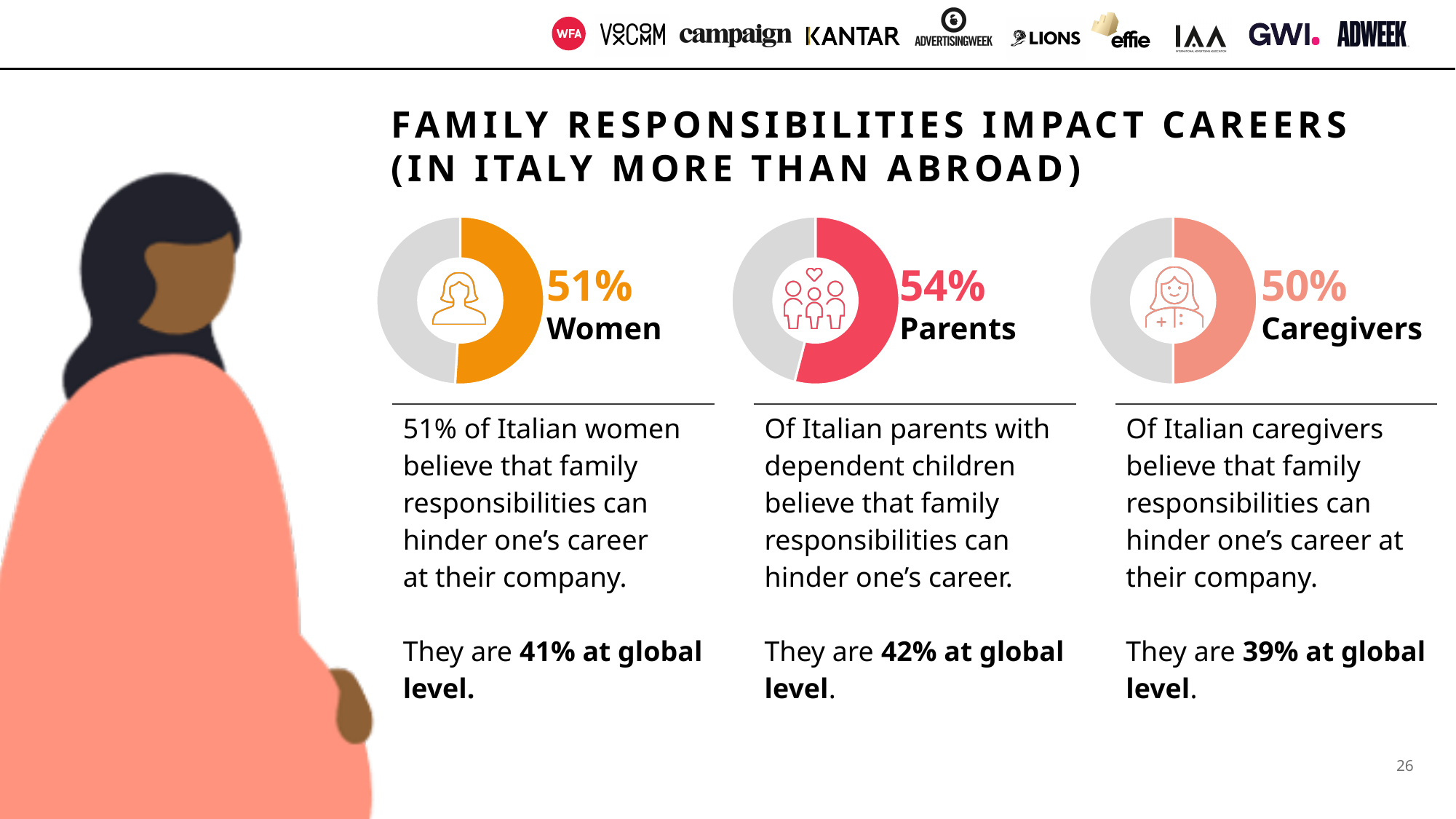
According to the text under the Caregivers chart, what is the caregivers figure at global level? 39% Which of the three donut charts shows the lowest percentage? Caregivers What colour is the filled portion of the Women donut chart? Orange Which is larger, the Women percentage or the Caregivers percentage? Women Which of the three donut charts shows the highest percentage? Parents What percentage is shown on the Women donut chart? 51% What percentage is shown on the Caregivers donut chart? 50% How many donut charts are shown on the slide? 3 What kind of chart is used to show the Women, Parents and Caregivers percentages? Donut (pie) chart What is the difference between the Parents percentage and the Women percentage? 3% What is the difference between the Parents percentage and the Caregivers percentage? 4% What percentage is shown on the Parents donut chart? 54%